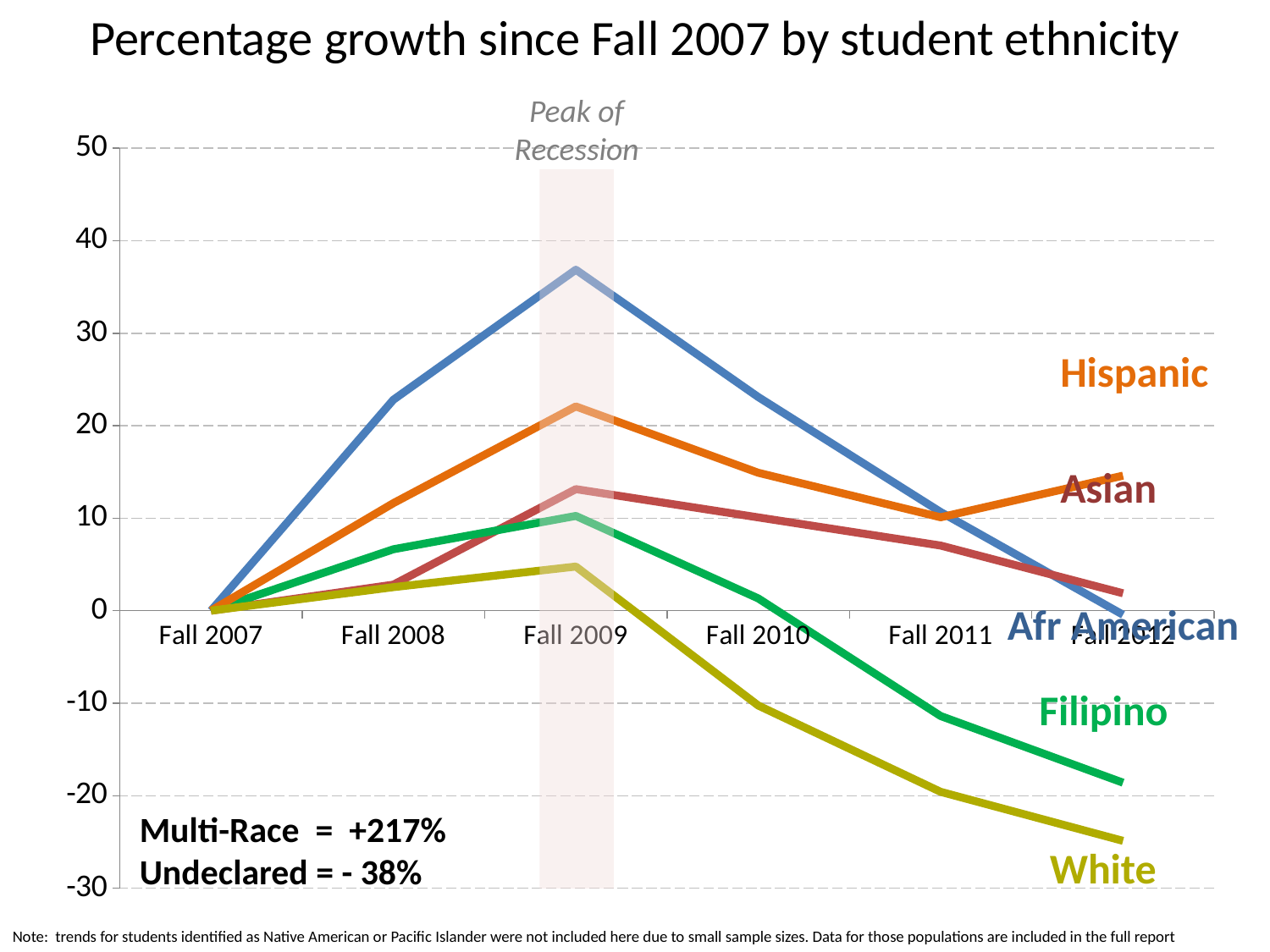
Which group has the lowest value in Fall 2012? White Does the White line rise or fall from Fall 2009 to Fall 2012? fall How many ethnic groups are plotted as lines on the chart? 5 Which time point is marked as the Peak of Recession? Fall 2009 What kind of chart is shown on the slide? line chart What is the value for Hispanic in Fall 2007? 0 Is the value for Hispanic in Fall 2009 greater or less than 20? greater In Fall 2012, which is larger: the value for Hispanic or the value for Asian? Hispanic Is the value for Afr American in Fall 2009 greater or less than 30? greater How many time points are shown along the x axis? 6 Is the value for White in Fall 2012 greater or less than -20? less Which group has the highest percentage growth in Fall 2009? Afr American